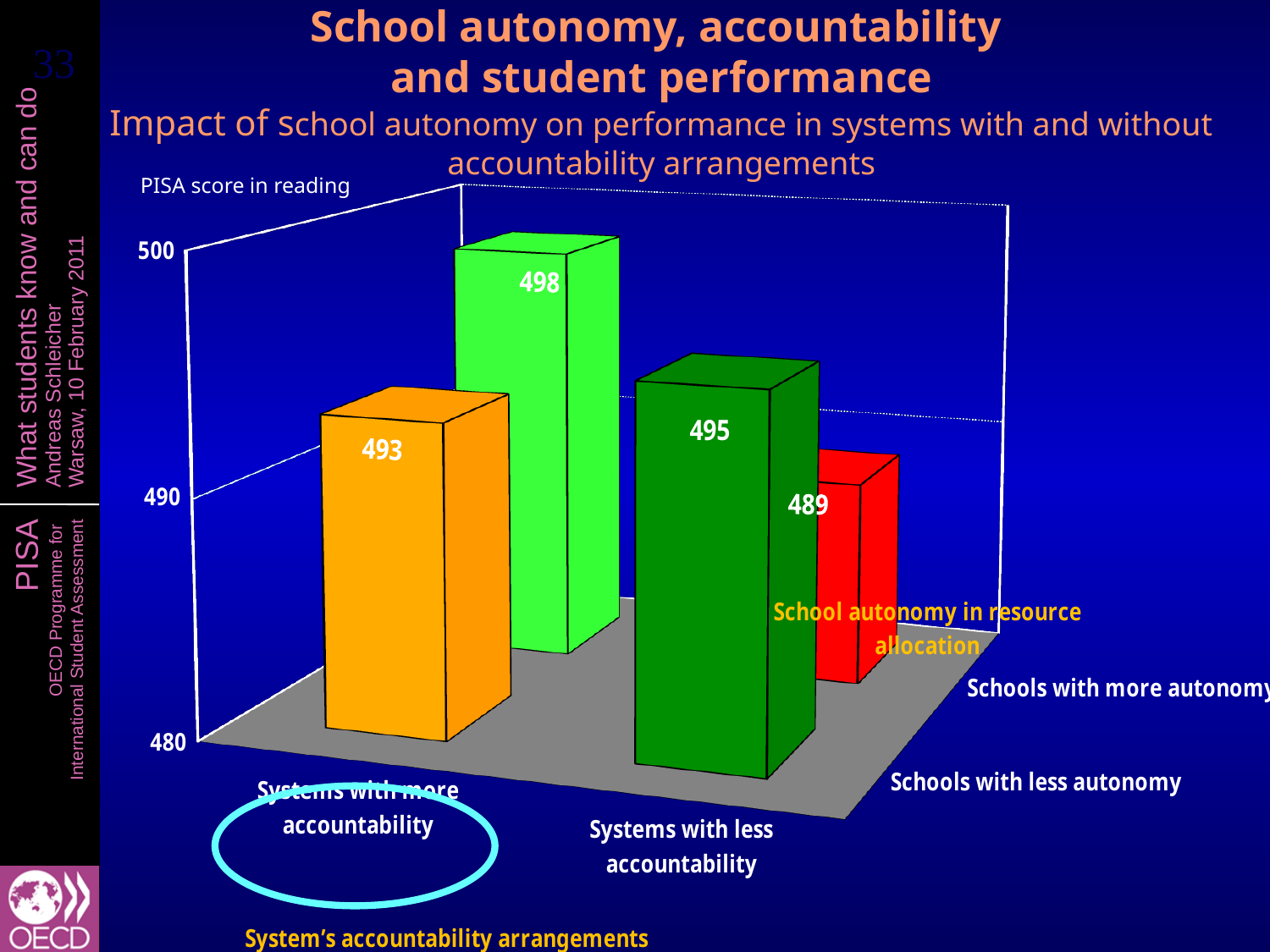
What is the value shown on the red bar? 489 What measure does the vertical axis represent, according to the label above it? PISA score in reading What is the value shown on the dark green bar? 495 What is the value shown on the light green bar? 498 Which bar is taller, the orange bar or the dark green bar? the dark green bar What is the difference between the highest bar (498) and the lowest bar (489)? 9 What is the lowest PISA reading score shown in the chart? 489 What is the highest PISA reading score shown in the chart? 498 What is the value shown on the orange bar? 493 Is the value of the red bar greater or less than 490? less What type of chart is shown on the slide? bar chart How many bars are plotted in the chart? 4